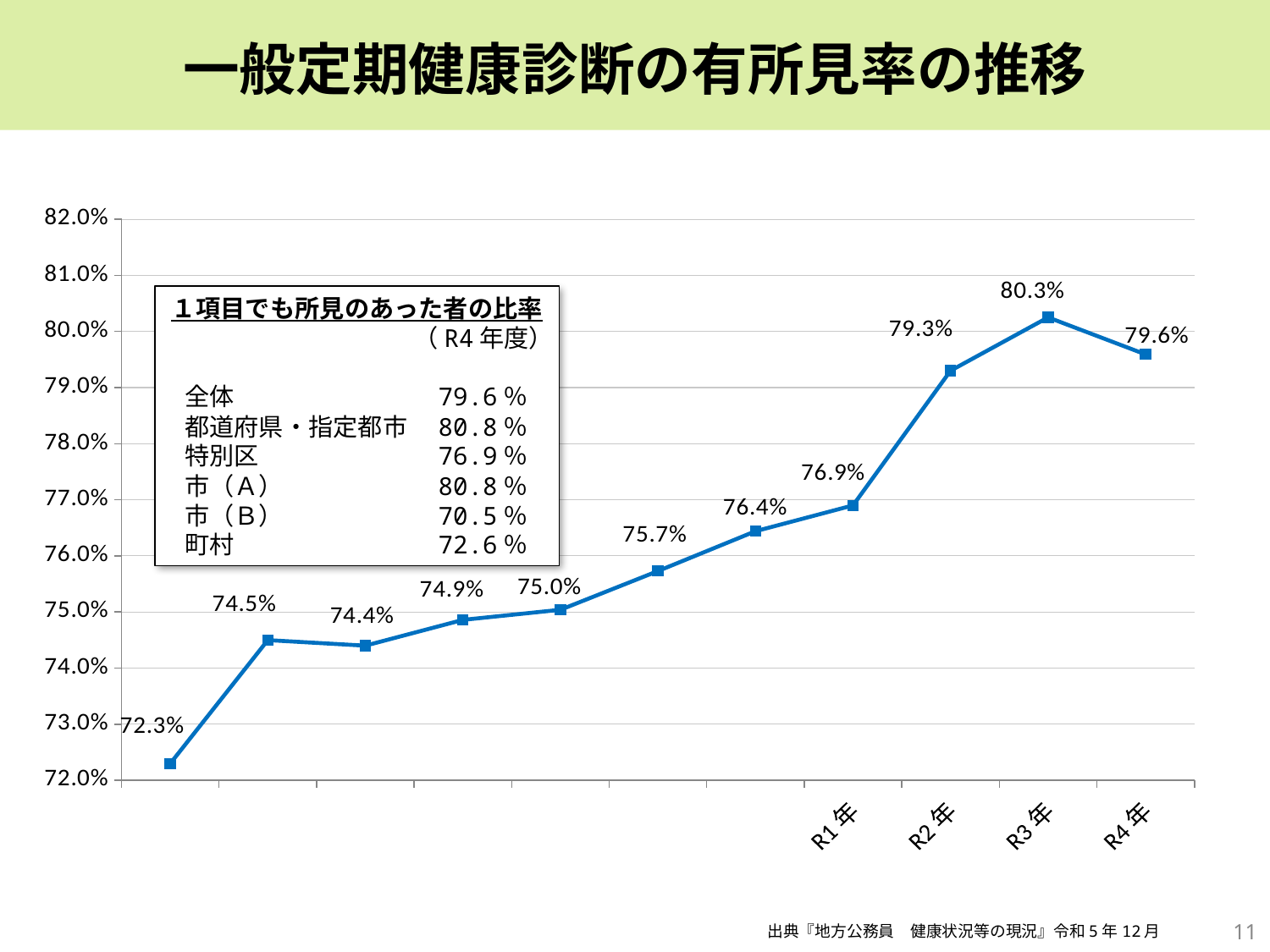
What is the value for R3年? 80.3% What is the lowest value plotted on the chart? 72.3% What is the difference between the values for R3年 and R4年? 0.7 percentage points How many data points are plotted on the line? 11 Which is larger, the value for R2年 or the value for R4年? R4年 Which year has the highest value on the chart? R3年 Overall, do the values rise or fall from the first point to R3年? rise What is the title of the chart on the slide? 一般定期健康診断の有所見率の推移 What is the value for R1年? 76.9% What kind of chart is shown on the slide? line chart What is the value for R4年? 79.6% What is the value for R2年? 79.3%